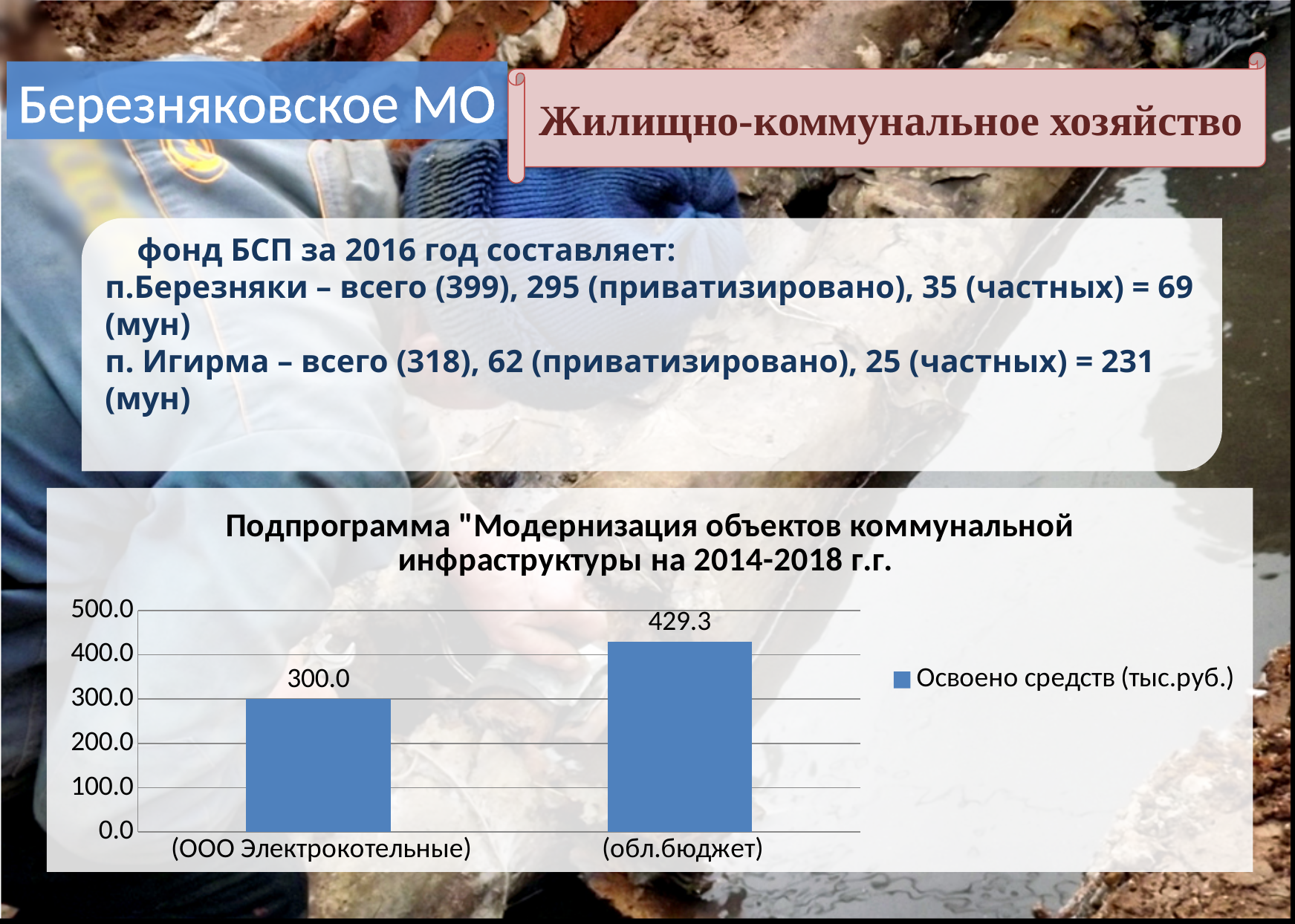
What is the difference between the values for (обл.бюджет) and (ООО Электрокотельные)? 129.3 What is the title of the chart? Подпрограмма "Модернизация объектов коммунальной инфраструктуры на 2014-2018 г.г. Is the value for (обл.бюджет) greater or less than 400.0? greater What is the value for (ООО Электрокотельные) in the chart? 300.0 What is the value for (обл.бюджет) in the chart? 429.3 How many categories are shown in the chart? 2 Which category has the lowest value in the chart? (ООО Электрокотельные) Which is larger: the value for (ООО Электрокотельные) or the value for (обл.бюджет)? (обл.бюджет) Which category has the highest value in the chart? (обл.бюджет) What kind of chart is shown on the slide? bar chart What is the legend entry of the chart? Освоено средств (тыс.руб.) How many series does the chart legend list? 1